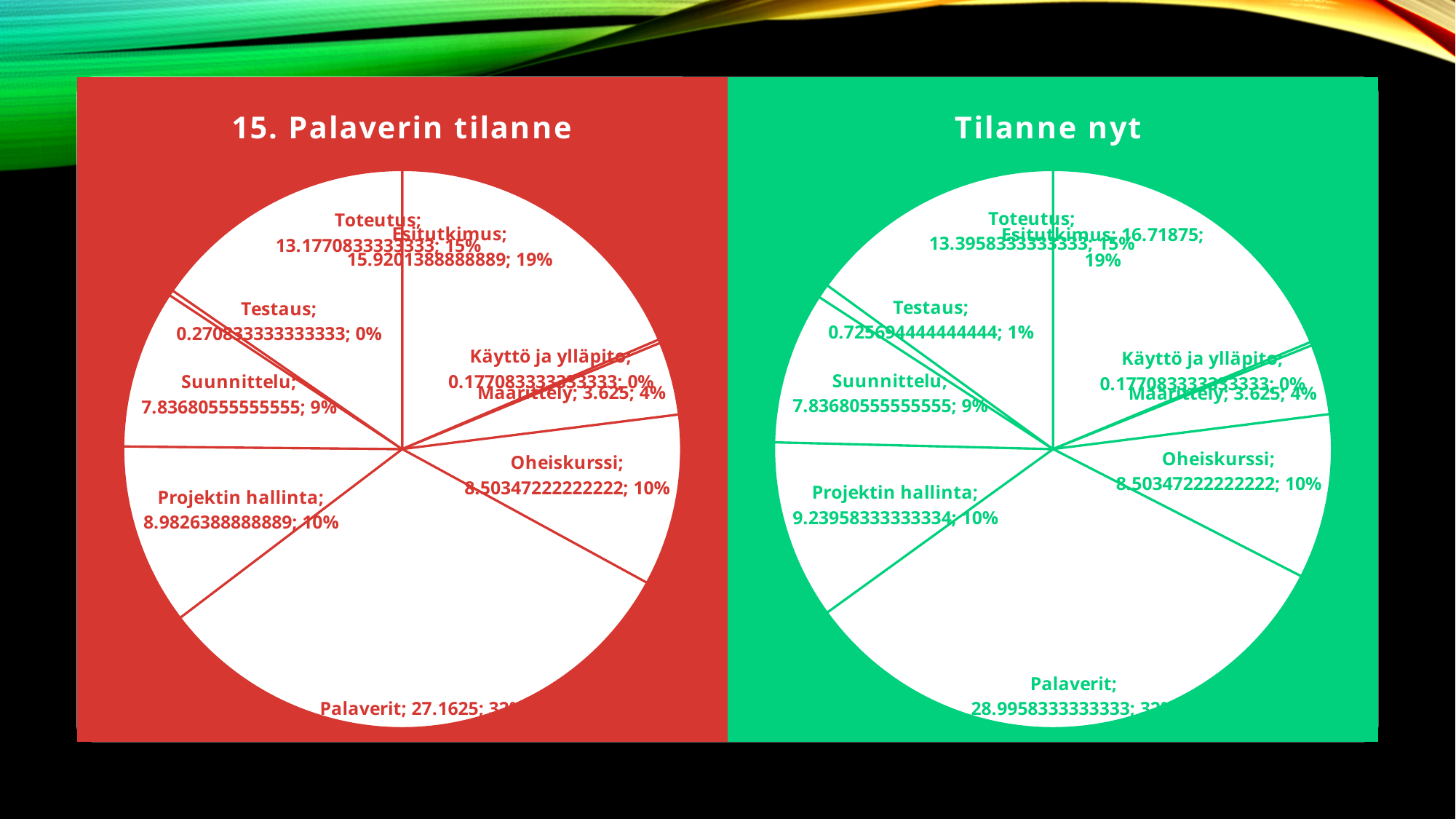
In the "15. Palaverin tilanne" chart, which category has the largest slice? Palaverit In the "Tilanne nyt" chart, what is the value for Oheiskurssi? 8.50347222222222 In the "Tilanne nyt" chart, how many slices (categories) are there? 9 What is the title of the chart on the left side of the slide? 15. Palaverin tilanne What kind of chart is shown under the title "15. Palaverin tilanne"? pie chart In the "Tilanne nyt" chart, which category has the smallest value? Käyttö ja ylläpito In the "Tilanne nyt" chart, what is the value for Testaus? 0.725694444444444 In the "Tilanne nyt" chart, what is the difference between the values for Määrittely and Käyttö ja ylläpito? 3.447916666666667 In the "Tilanne nyt" chart, which is larger: Projektin hallinta or Oheiskurssi? Projektin hallinta In the "Tilanne nyt" chart, what share of the pie does Suunnittelu have? 9% In the "15. Palaverin tilanne" chart, what share of the pie does Esitutkimus have? 19% In the "15. Palaverin tilanne" chart, what is the value for Määrittely? 3.625